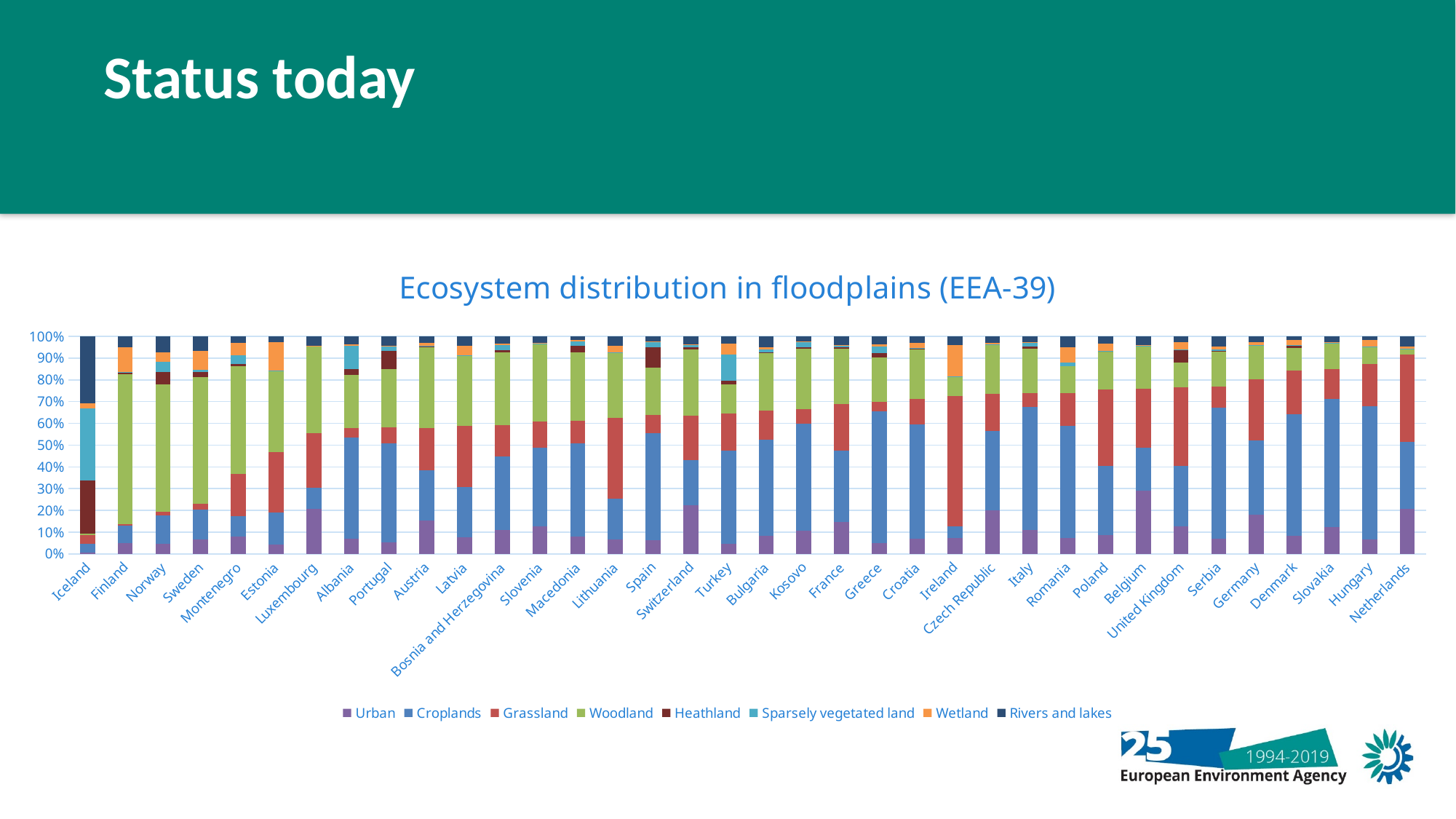
Is the Woodland share for Finland greater or less than 60%? greater Which country has the largest share of Rivers and lakes? Iceland Does the Croplands share generally rise or fall from left to right across the countries? rise How many series does the legend list? 8 What is the title of the chart? Ecosystem distribution in floodplains (EEA-39) Is the Croplands share for Iceland greater or less than 10%? less How many countries are shown on the x axis? 36 What type of chart is shown on the slide? Stacked bar chart Which country has the largest share of Sparsely vegetated land? Iceland Which country has the largest share of Heathland? Iceland Which has the larger Croplands share, Slovakia or Iceland? Slovakia